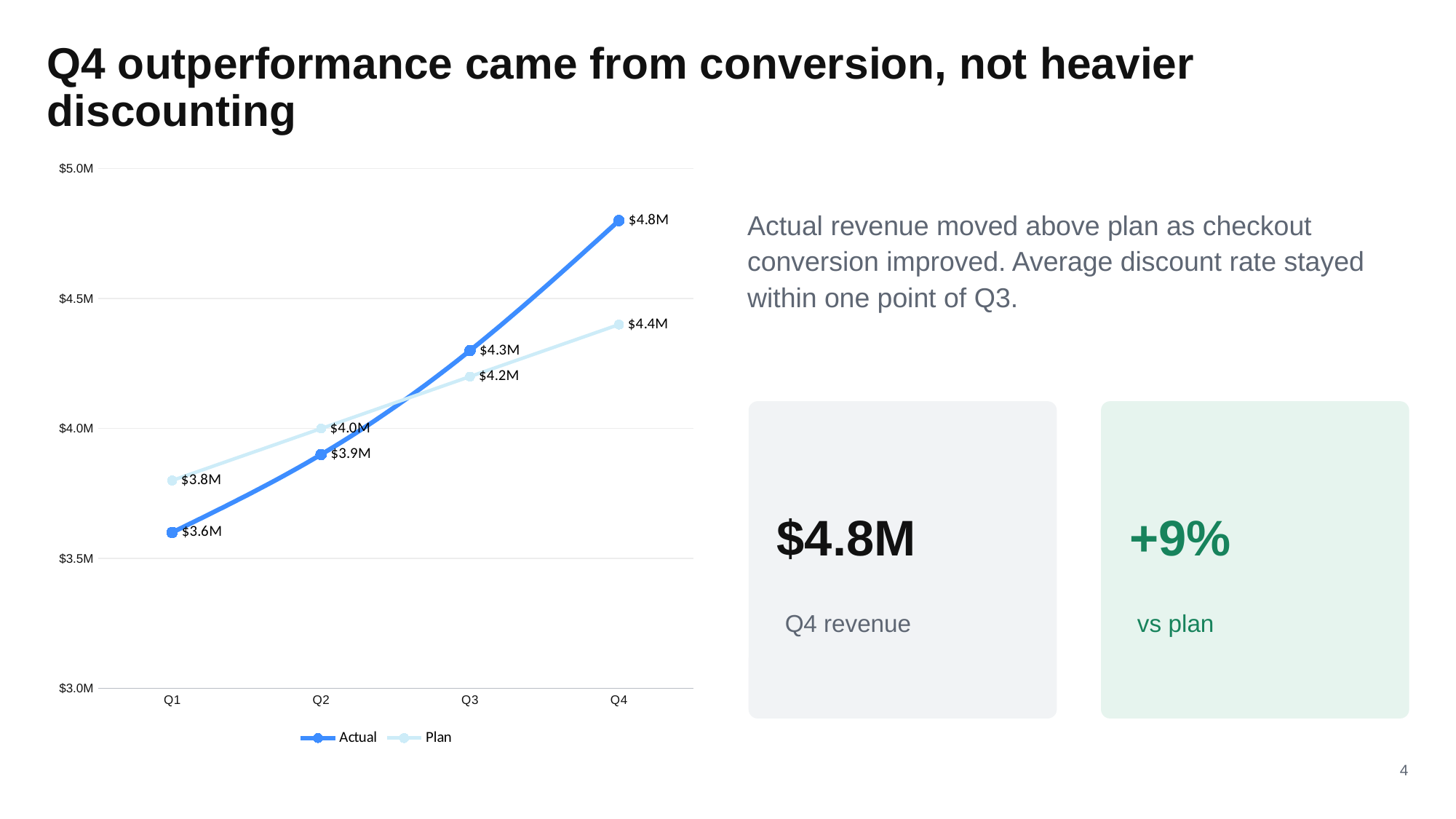
What is the Plan value for Q2? $4.0M What is the Actual value for Q1? $3.6M What kind of chart is shown on the slide? Line chart Which is larger in Q2, Actual or Plan? Plan How many quarters are plotted on the x axis? 4 What is the difference between Actual and Plan in Q4? $0.4M Does the Actual series rise or fall from Q1 to Q4? Rise What is the Actual value for Q4? $4.8M In which quarter is the Plan series lowest? Q1 In which quarter is the Actual series highest? Q4 How many series does the legend list? 2 What is the Plan value for Q4? $4.4M